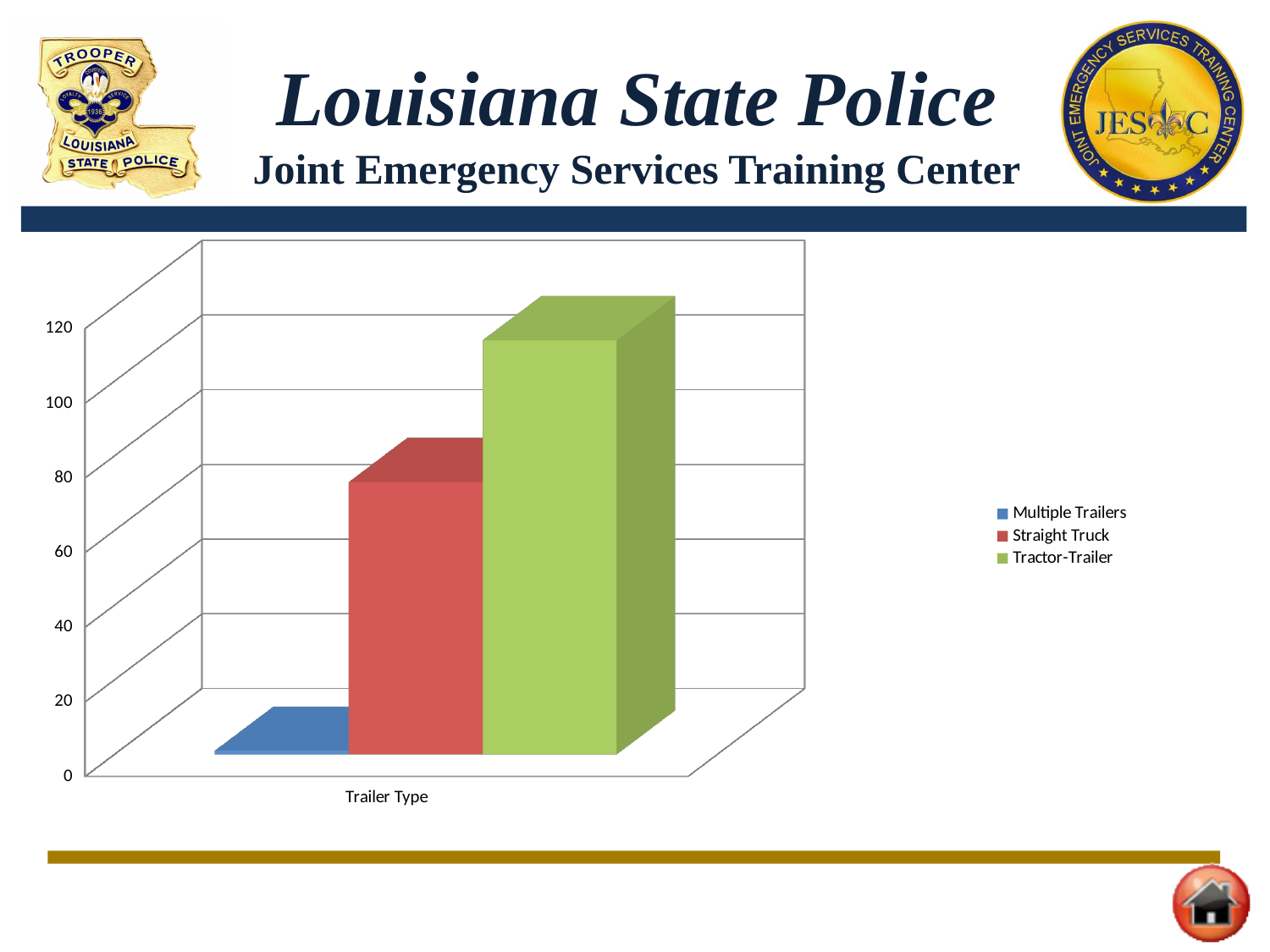
Which is larger, the value for Multiple Trailers or the value for Straight Truck? Straight Truck Which series has the lowest value? Multiple Trailers What kind of chart is shown on the slide? bar chart Is the value for Multiple Trailers greater or less than 20? less Is the value for Tractor-Trailer greater or less than 100? greater Is the value for Straight Truck greater or less than 100? less Which is larger, the value for Straight Truck or the value for Tractor-Trailer? Tractor-Trailer What is the label shown on the horizontal axis of the chart? Trailer Type What colour is the bar for Tractor-Trailer? green How many series does the legend list? 3 Which series has the highest value? Tractor-Trailer